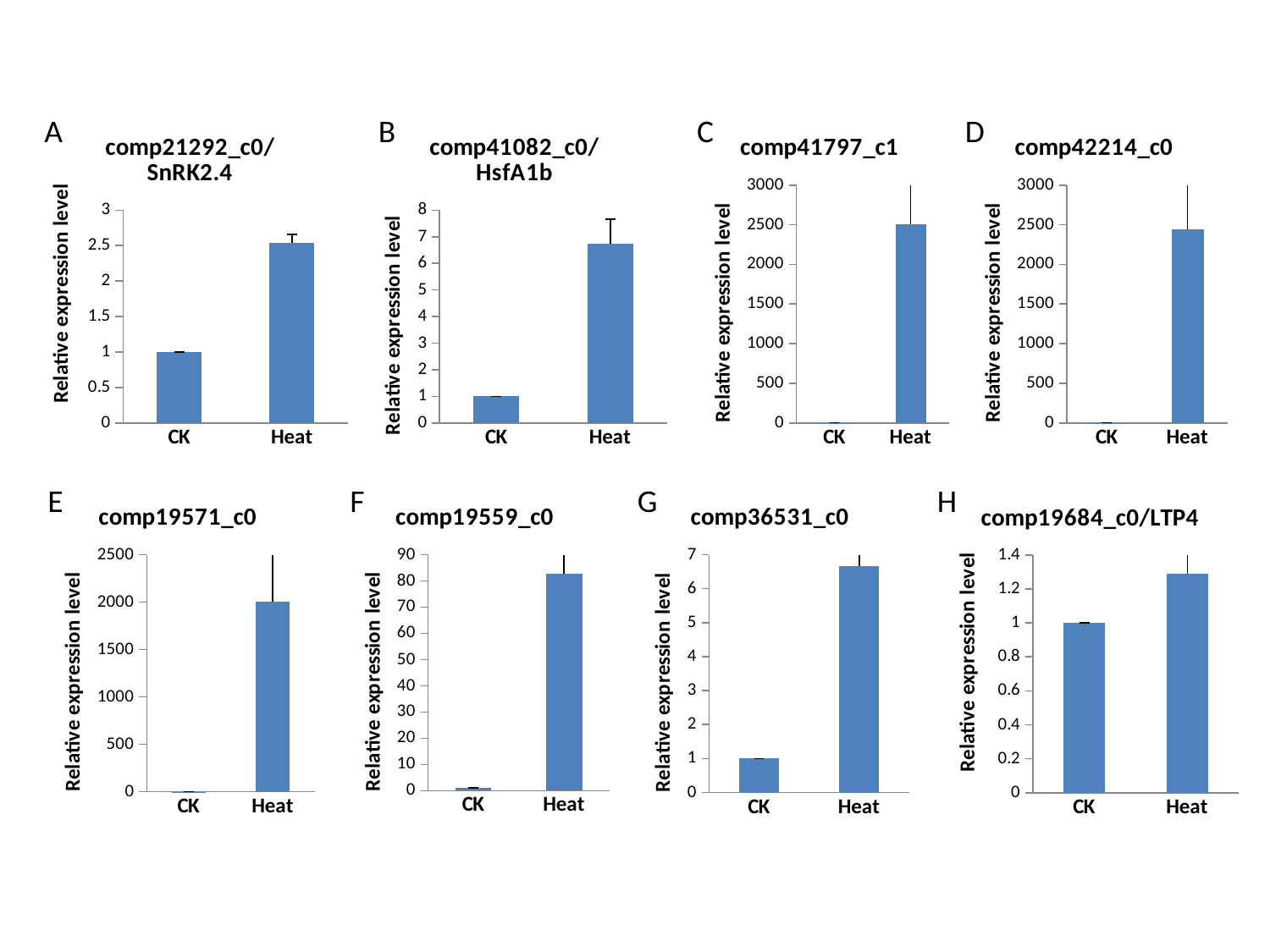
In chart E (comp19571_c0), is the value for Heat greater or less than 1500? greater In chart A (comp21292_c0/SnRK2.4), which category has the lowest relative expression level? CK In chart H (comp19684_c0/LTP4), is the value for Heat greater or less than 1.2? greater In chart B (comp41082_c0/HsfA1b), is the value for Heat greater or less than 6? greater In chart G (comp36531_c0), what is the relative expression level for CK? 1 How many categories are shown on the x axis of chart F (comp19559_c0)? 2 What kind of chart is chart C (comp41797_c1)? Bar chart In chart D (comp42214_c0), which category has the higher relative expression level, CK or Heat? Heat In chart A (comp21292_c0/SnRK2.4), what is the relative expression level for CK? 1 What is the y-axis label of chart H (comp19684_c0/LTP4)? Relative expression level